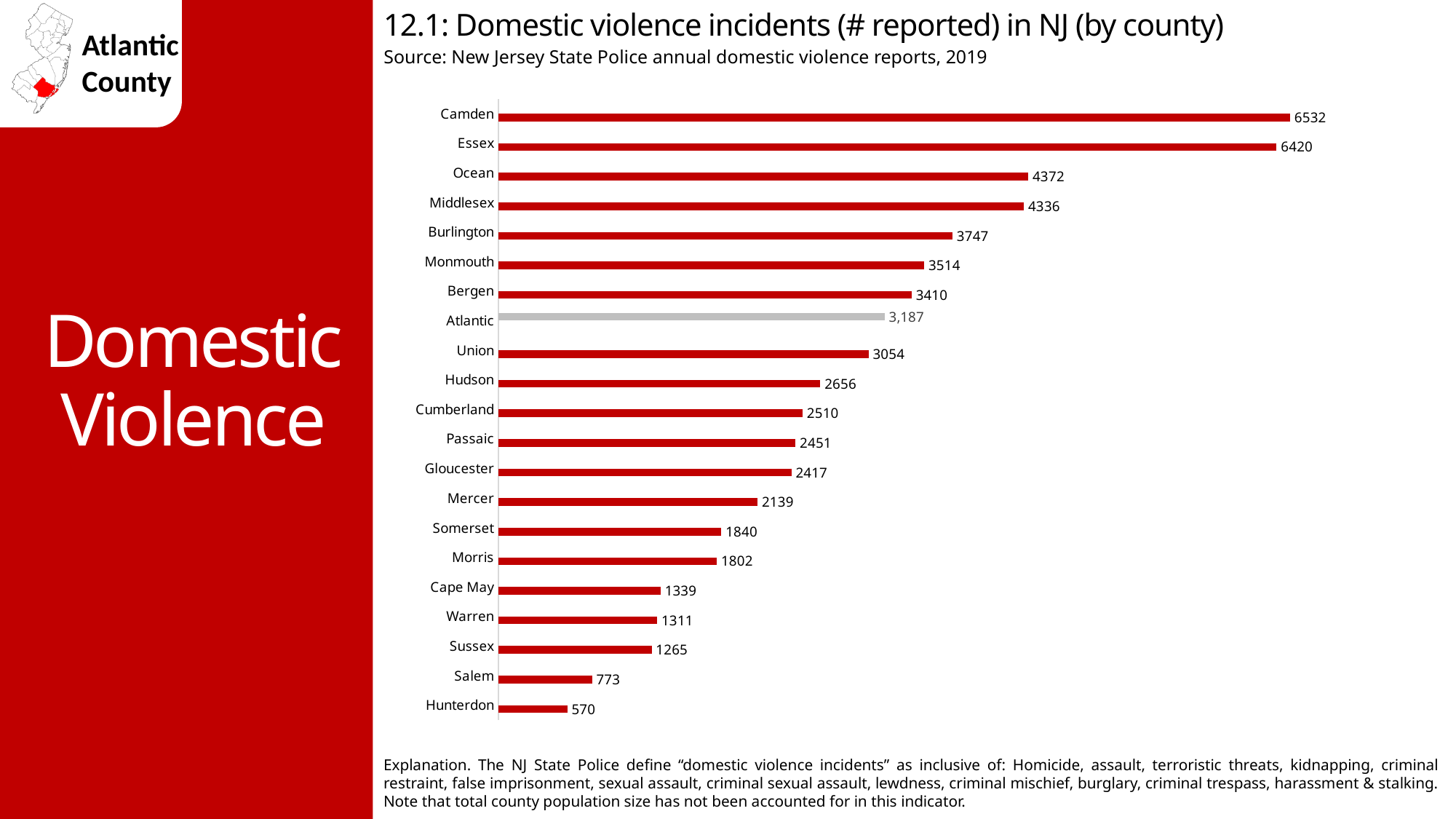
How many counties are shown in the chart? 21 Which county has more reported incidents, Ocean or Middlesex? Ocean Which county has more reported incidents, Salem or Sussex? Sussex What is the difference in reported incidents between Camden and Essex? 112 What is the difference in reported incidents between Bergen and Atlantic? 223 Which county has the highest number of reported domestic violence incidents? Camden What is the number of reported domestic violence incidents for Camden? 6532 What is the number of reported domestic violence incidents for Hunterdon? 570 Which county has the lowest number of reported domestic violence incidents? Hunterdon What is the number of reported domestic violence incidents for Atlantic County? 3,187 What type of chart is used to show domestic violence incidents by county? Bar chart Which county's bar is shown in grey rather than red? Atlantic